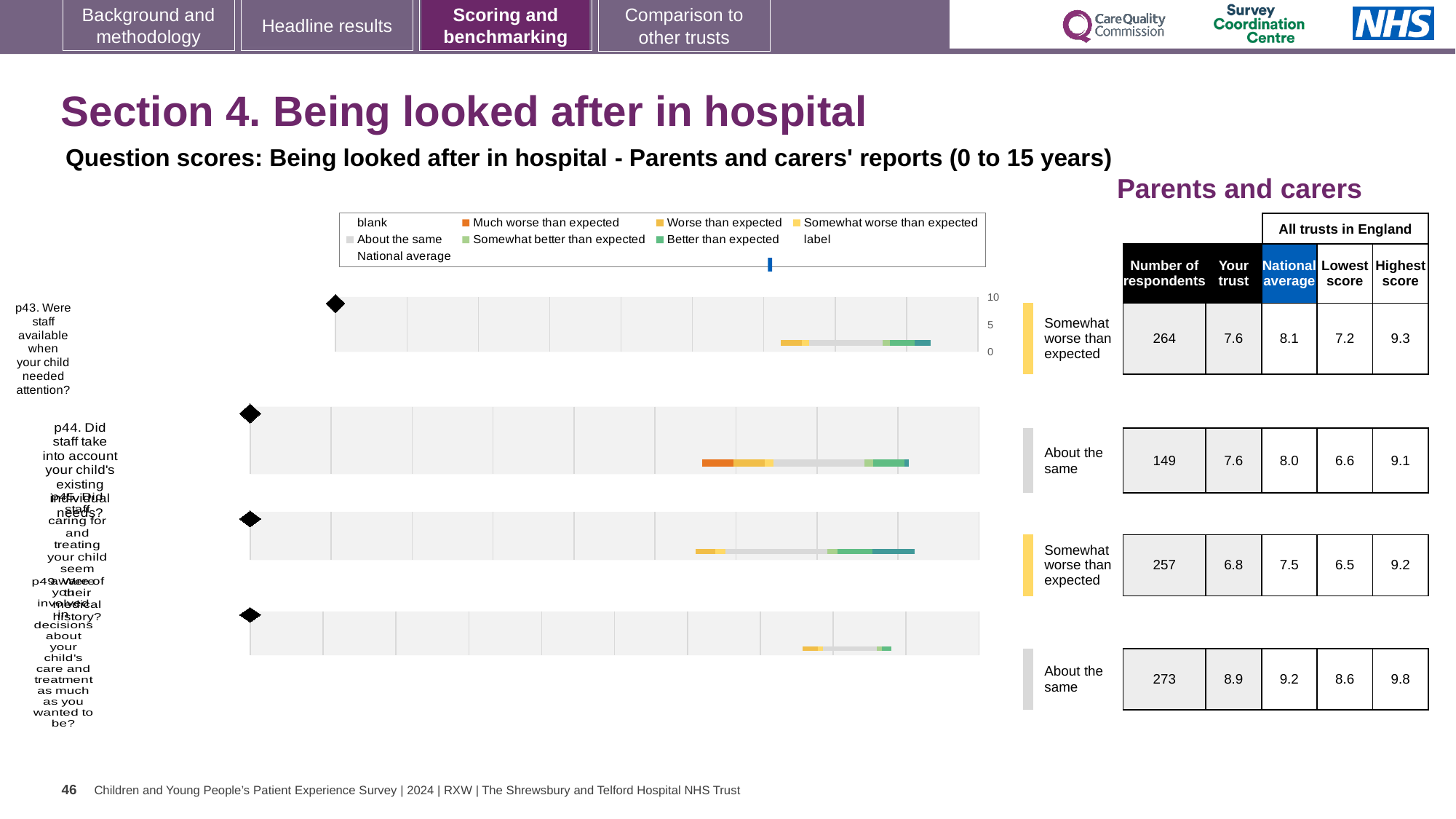
What is the national average score shown for the third chart (p45)? 7.5 How many question charts are shown on the slide? 4 What is the highest score among all trusts in England shown for the fourth chart (p49)? 9.8 In the table next to the charts, how many respondents are listed for the first chart (p43, Were staff available when your child needed attention)? 264 What is the 'Your trust' score shown for the first chart (p43)? 7.6 For the first chart (p43), which is larger: the 'Your trust' score or the national average? National average What is the lowest score among all trusts in England shown for the second chart (p44)? 6.6 For the fourth chart (p49), what is the difference between the national average and the 'Your trust' score? 0.3 Which question has the lowest 'Your trust' score on the slide? p45 What kind of chart is used to show each question score on the slide? Bar chart What benchmark category is shown for the third chart (p45)? Somewhat worse than expected Which question has the highest 'Your trust' score on the slide? p49